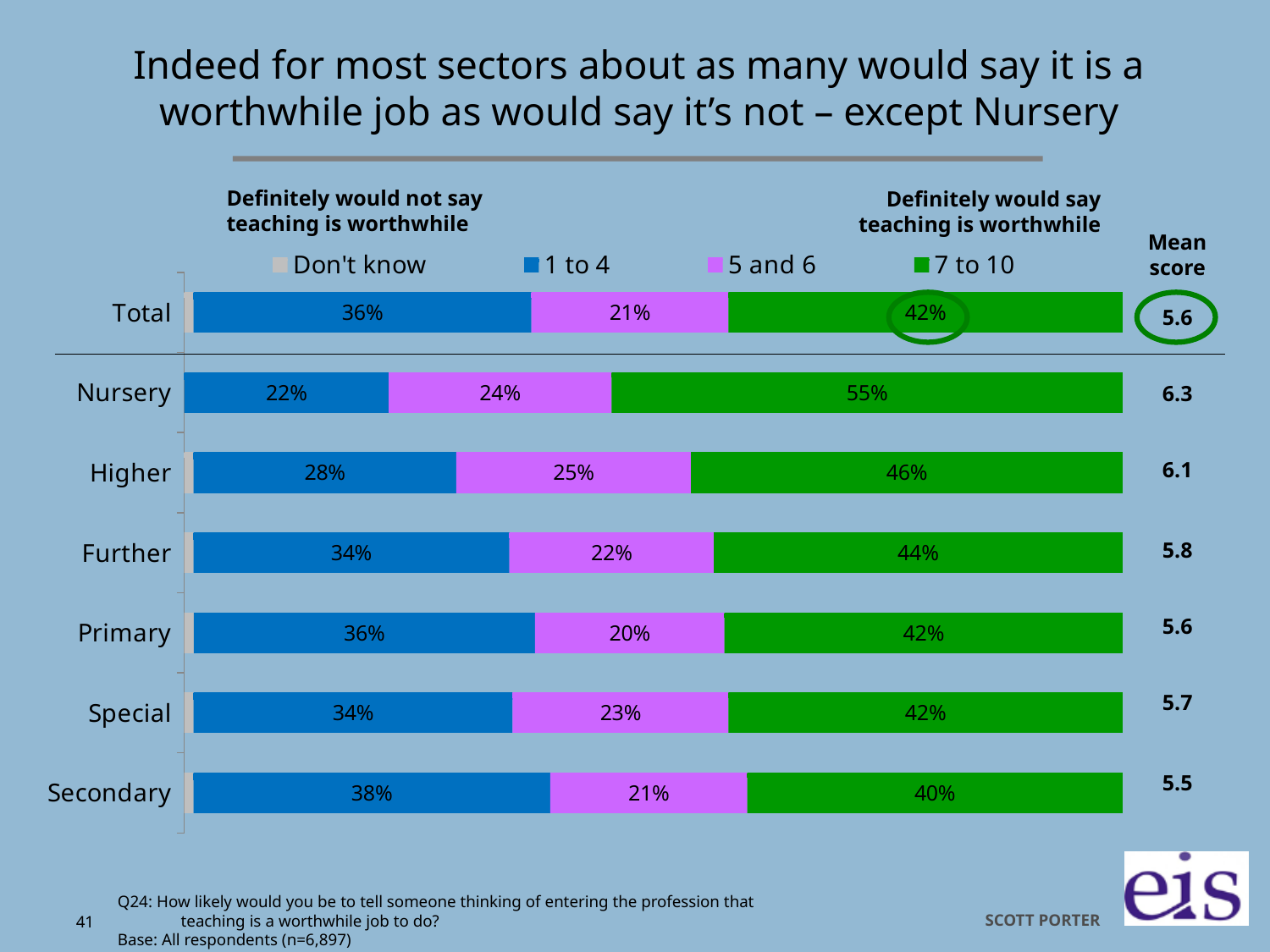
What is the mean score shown for Nursery? 6.3 Which sector has the lowest percentage in the 1 to 4 category? Nursery What percentage of Nursery respondents gave a score of 7 to 10? 55% How many sector categories (including Total) are shown on the chart? 7 What is the value of the 5 and 6 segment for Higher? 25% What is the difference between the 7 to 10 percentage for Nursery and for Secondary? 15 percentage points What is the value of the 1 to 4 segment for Secondary? 38% Which sector has the highest percentage in the 7 to 10 category? Nursery Which has a larger 1 to 4 percentage, Higher or Further? Further What kind of chart is shown on the slide? Stacked bar chart How many series does the legend list? 4 Which sector has the lowest percentage in the 7 to 10 category? Secondary